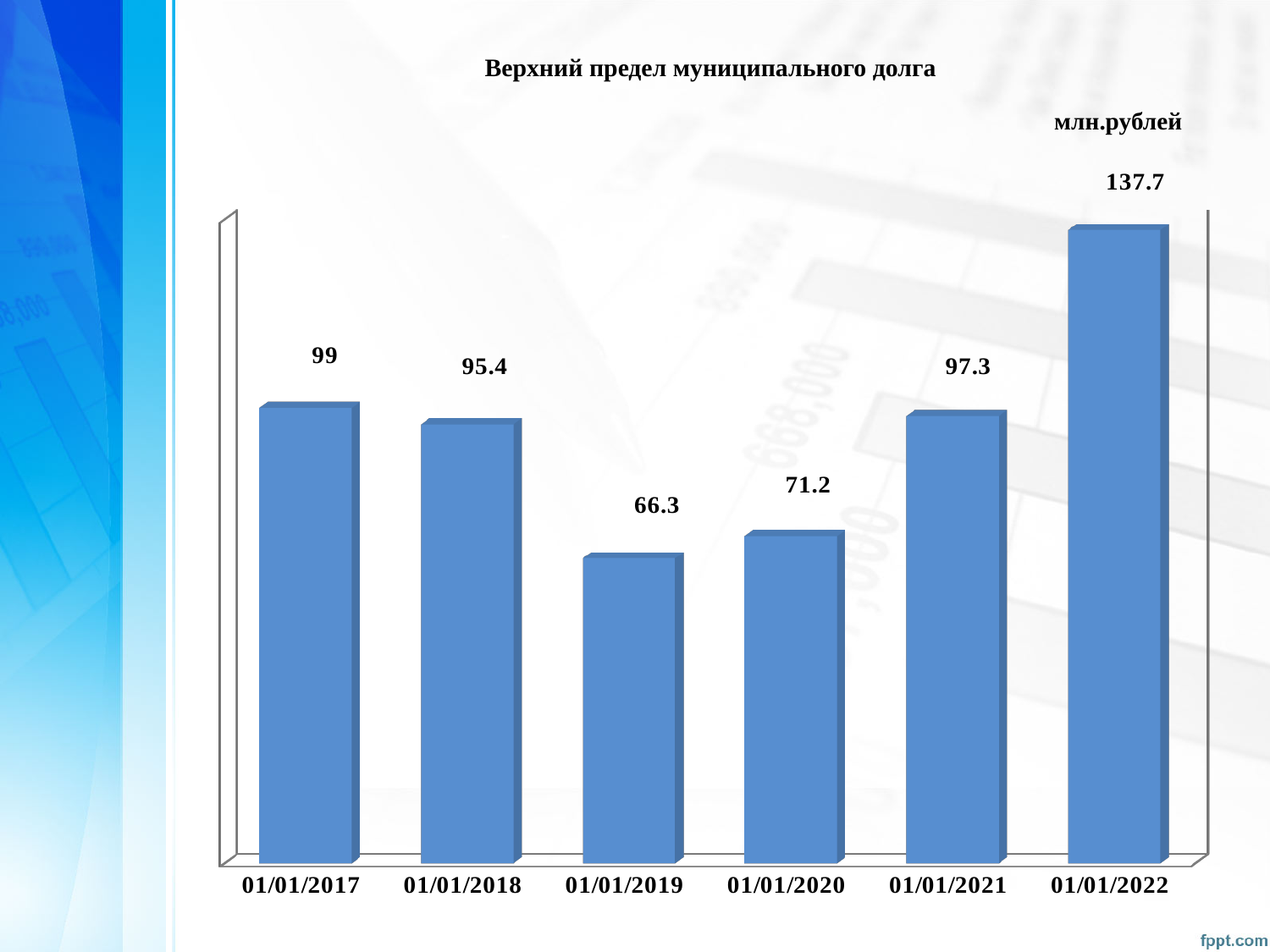
What is the value for 01/01/2019? 66.3 What unit is shown for the values on the chart? млн.рублей How many dates are shown on the x axis? 6 What is the value for 01/01/2022? 137.7 What kind of chart is this? bar chart What is the value for 01/01/2017? 99 Which date has the lowest value? 01/01/2019 What is the difference between the values for 01/01/2022 and 01/01/2021? 40.4 What is the difference between the values for 01/01/2020 and 01/01/2019? 4.9 Which date has the highest value? 01/01/2022 Which is larger, the value for 01/01/2017 or the value for 01/01/2018? 01/01/2017 What is the title of the chart? Верхний предел муниципального долга